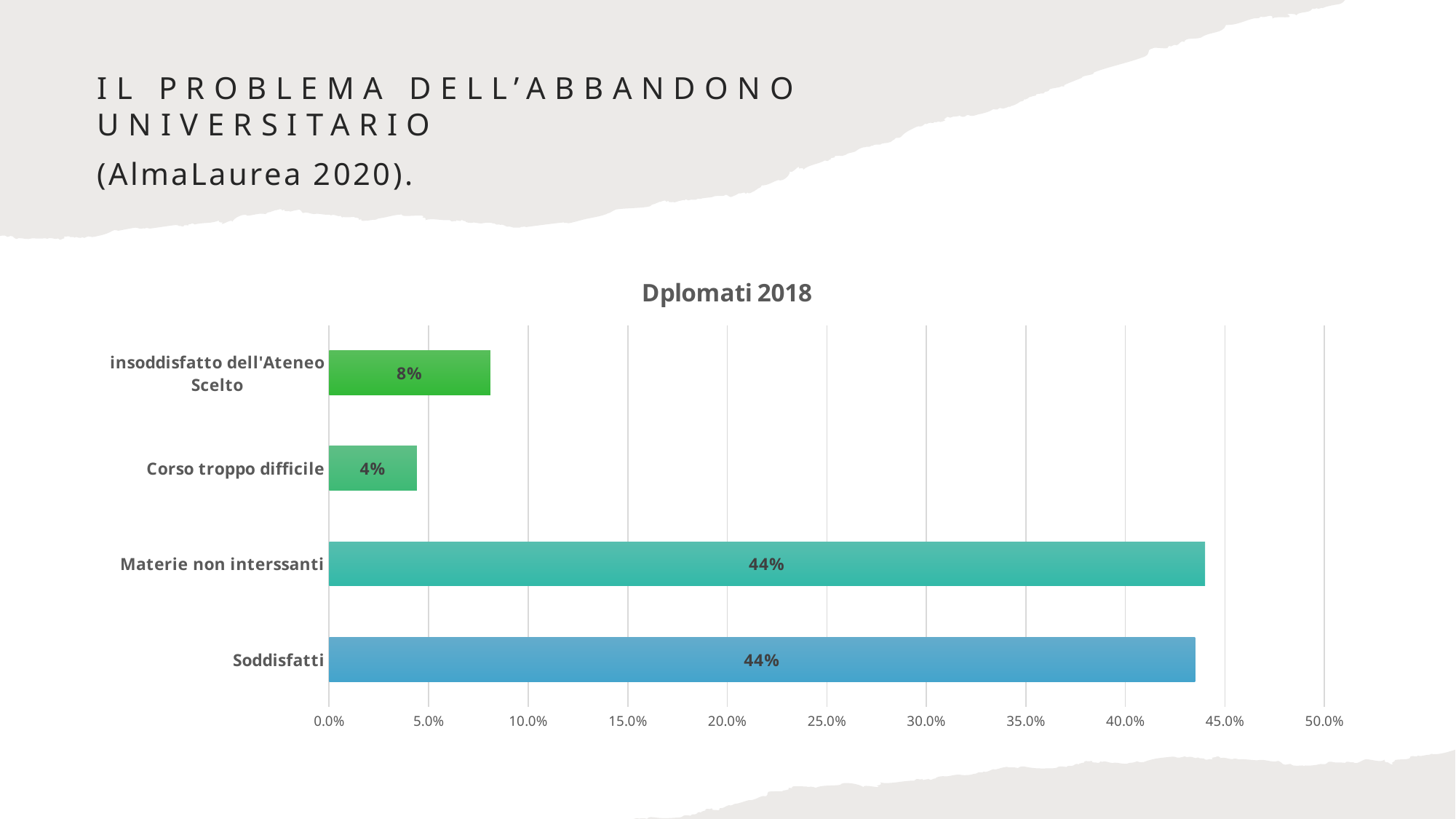
What is the value for Materie non interssanti? 44% Which category has the lowest value? Corso troppo difficile What is the title of the chart? Dplomati 2018 Which is larger, the value for insoddisfatto dell'Ateneo Scelto or the value for Corso troppo difficile? insoddisfatto dell'Ateneo Scelto What is the value for insoddisfatto dell'Ateneo Scelto? 8% What is the value for Soddisfatti? 44% What is the difference between the values for insoddisfatto dell'Ateneo Scelto and Corso troppo difficile? 4% What is the value for Corso troppo difficile? 4% What is the difference between the values for Materie non interssanti and insoddisfatto dell'Ateneo Scelto? 36% What kind of chart is shown on the slide? bar chart Is the value for Materie non interssanti greater or less than 40.0%? greater How many categories are shown in the chart? 4